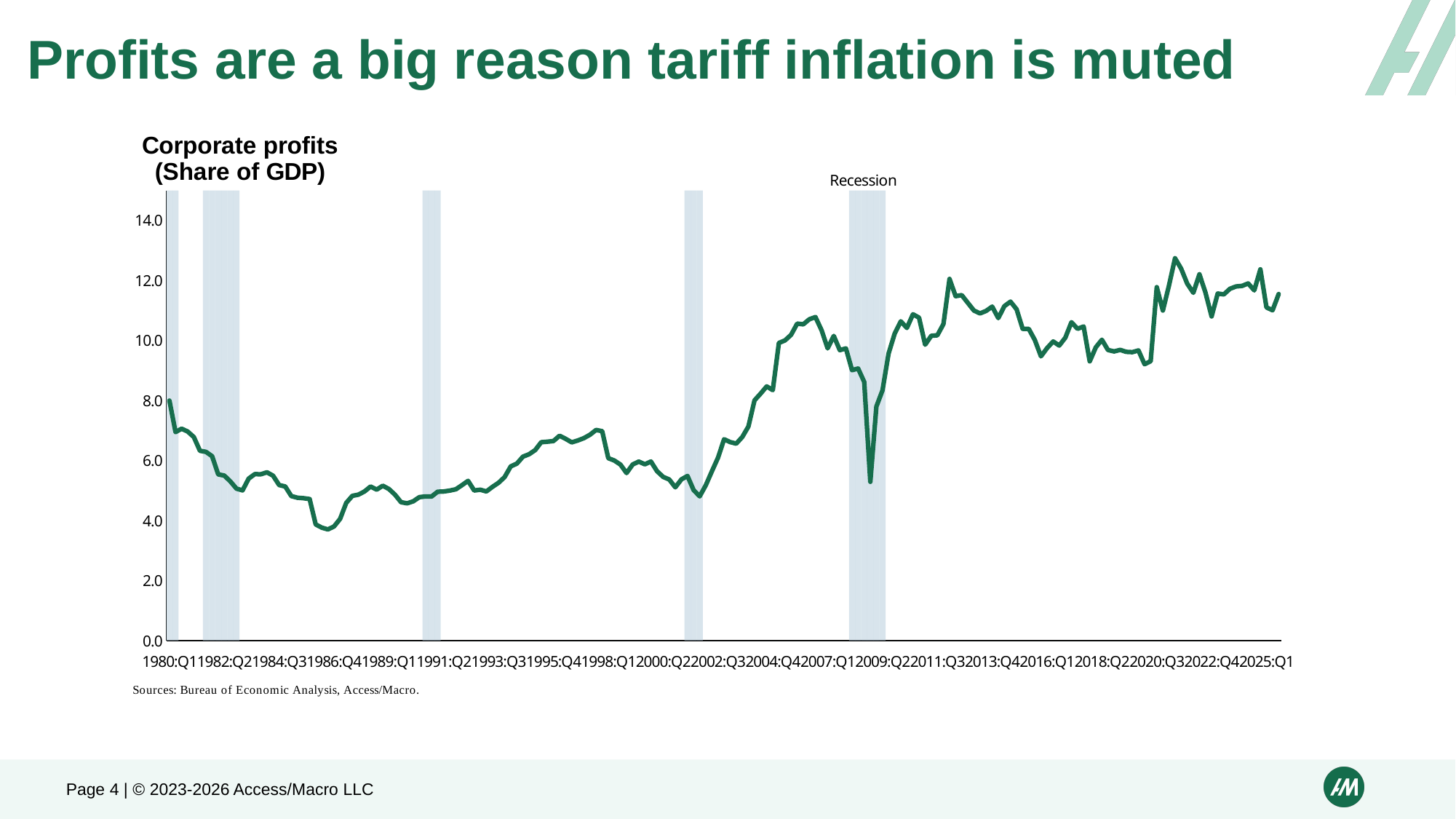
What is the title of the chart? Corporate profits (Share of GDP) Is the value for 2009:Q2 greater or less than 6.0? greater How many shaded recession bands are shown on the chart? 5 Is the value for 1991:Q2 greater or less than 6.0? less How many data series are plotted as lines in the chart? 1 Which is larger, the value for 1995:Q4 or the value for 2013:Q4? 2013:Q4 Is the value for 2025:Q1 greater or less than 10.0? greater What kind of chart is shown on the slide? Line chart Which is larger, the value for 1980:Q1 or the value for 2025:Q1? 2025:Q1 Overall, does corporate profits' share of GDP rise or fall from 1980:Q1 to 2025:Q1? rise